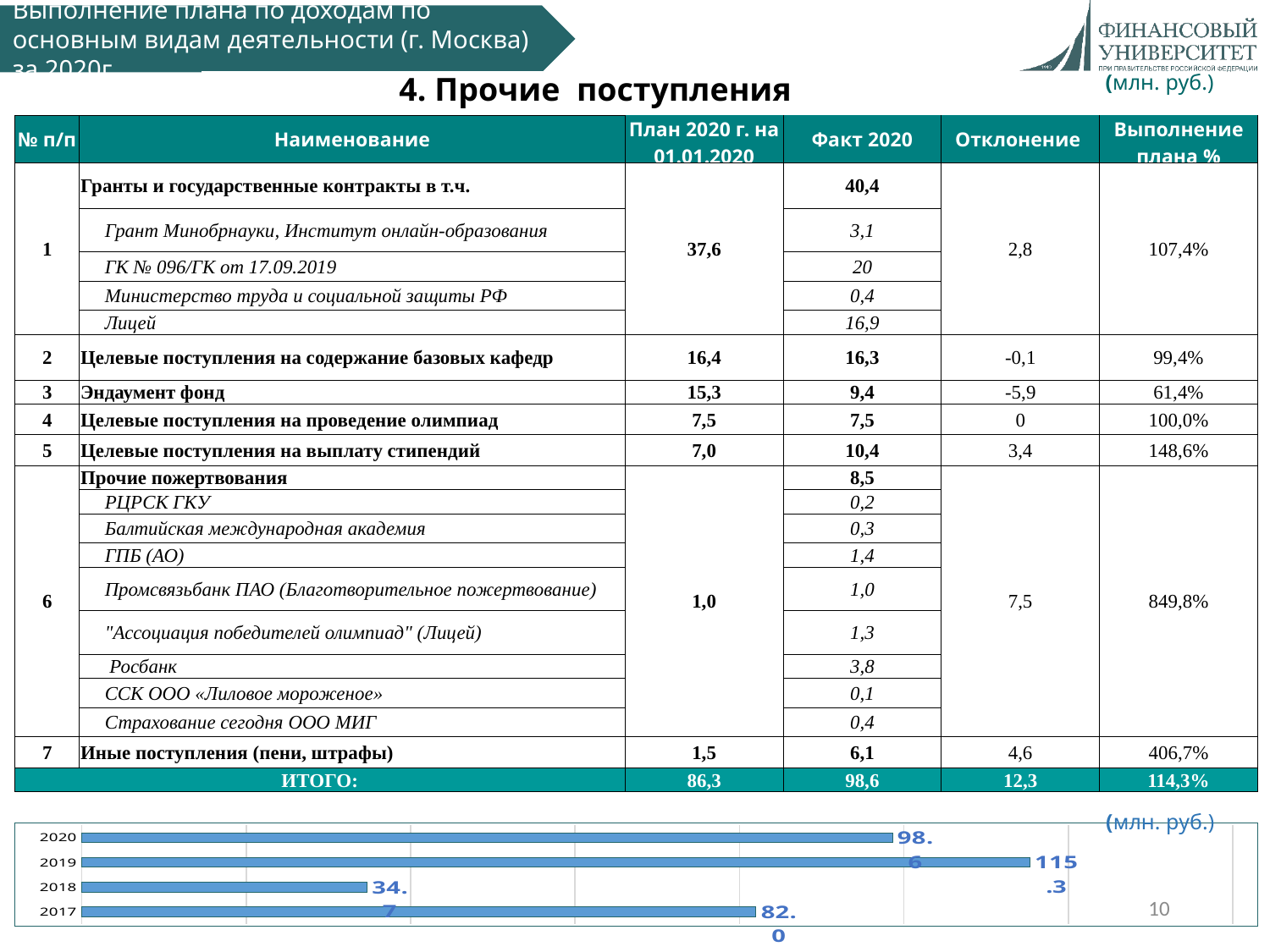
What kind of chart is shown at the bottom of the slide? bar chart In the bar chart at the bottom of the slide, does the value rise or fall from 2019 to 2020? fall In the bar chart at the bottom of the slide, what is the value for 2020? 98.6 In the bar chart at the bottom of the slide, which year has the highest value? 2019 In the bar chart at the bottom of the slide, by how much does the value for 2019 exceed the value for 2020? 16.7 In the bar chart at the bottom of the slide, which year has the lowest value? 2018 In the bar chart at the bottom of the slide, what is the value for 2018? 34.7 How many years are plotted in the bar chart at the bottom of the slide? 4 In the bar chart at the bottom of the slide, what is the value for 2017? 82.0 In the bar chart at the bottom of the slide, which is larger, the value for 2017 or the value for 2018? 2017 In the bar chart at the bottom of the slide, what is the value for 2019? 115.3 What unit is indicated next to the bar chart at the bottom of the slide? млн. руб.